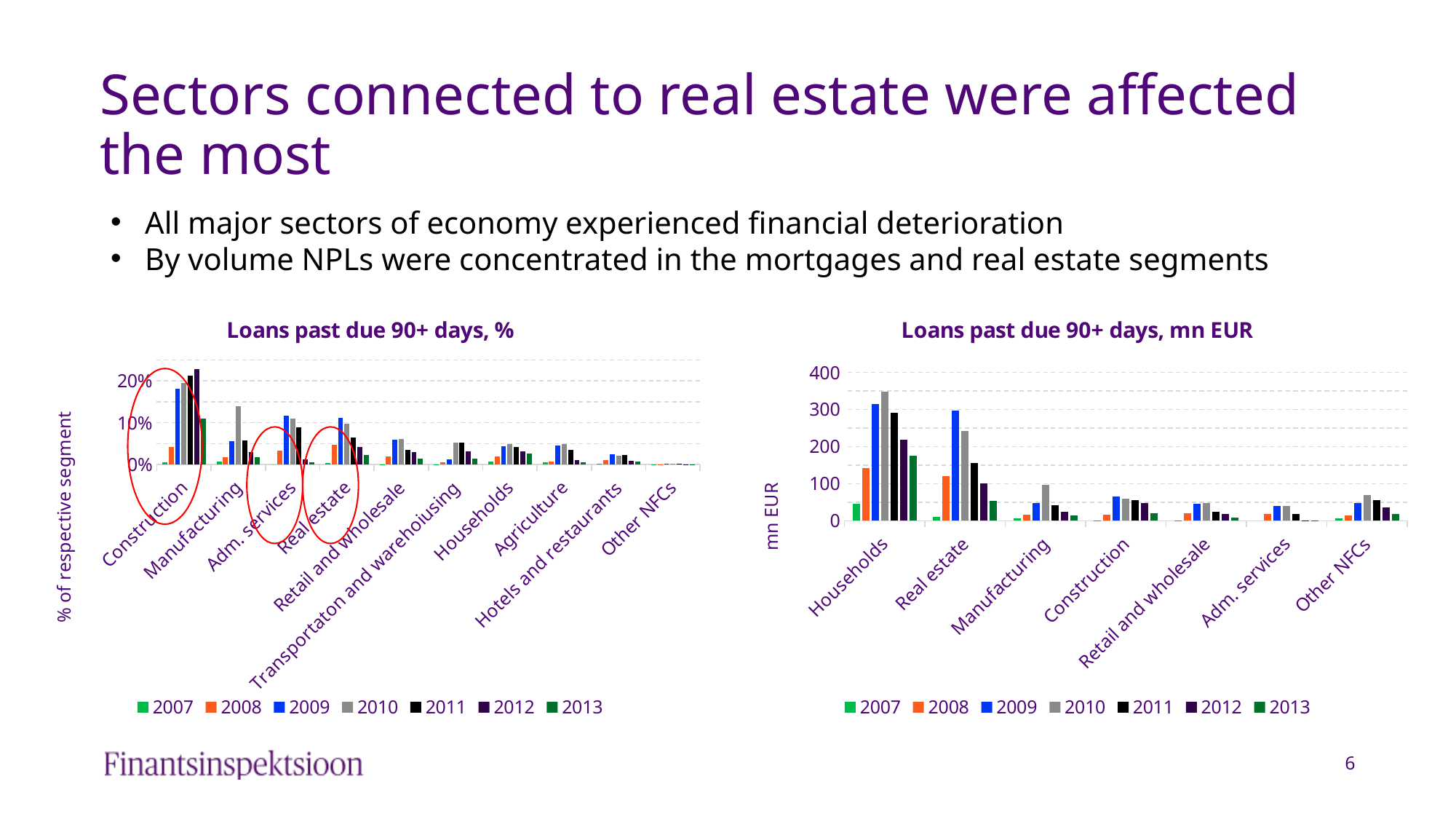
What kind of chart is the 'Loans past due 90+ days, mn EUR' chart? bar chart In the 'Loans past due 90+ days, %' chart, is the 2012 value for Construction greater or less than 20%? greater How many series does the legend of the 'Loans past due 90+ days, %' chart list? 7 In the 'Loans past due 90+ days, mn EUR' chart, is the 2013 value for Households greater or less than 200? less In the 'Loans past due 90+ days, mn EUR' chart, is the 2010 value for Households greater or less than 300? greater In the 'Loans past due 90+ days, mn EUR' chart, which category has the highest 2010 value? Households How many categories are shown on the x axis of the 'Loans past due 90+ days, mn EUR' chart? 7 How many categories are shown on the x axis of the 'Loans past due 90+ days, %' chart? 10 What is the y-axis label of the 'Loans past due 90+ days, %' chart? % of respective segment In the 'Loans past due 90+ days, mn EUR' chart, which is larger: the 2010 value for Households or the 2010 value for Real estate? Households In the 'Loans past due 90+ days, %' chart, which category has the highest 2012 value? Construction